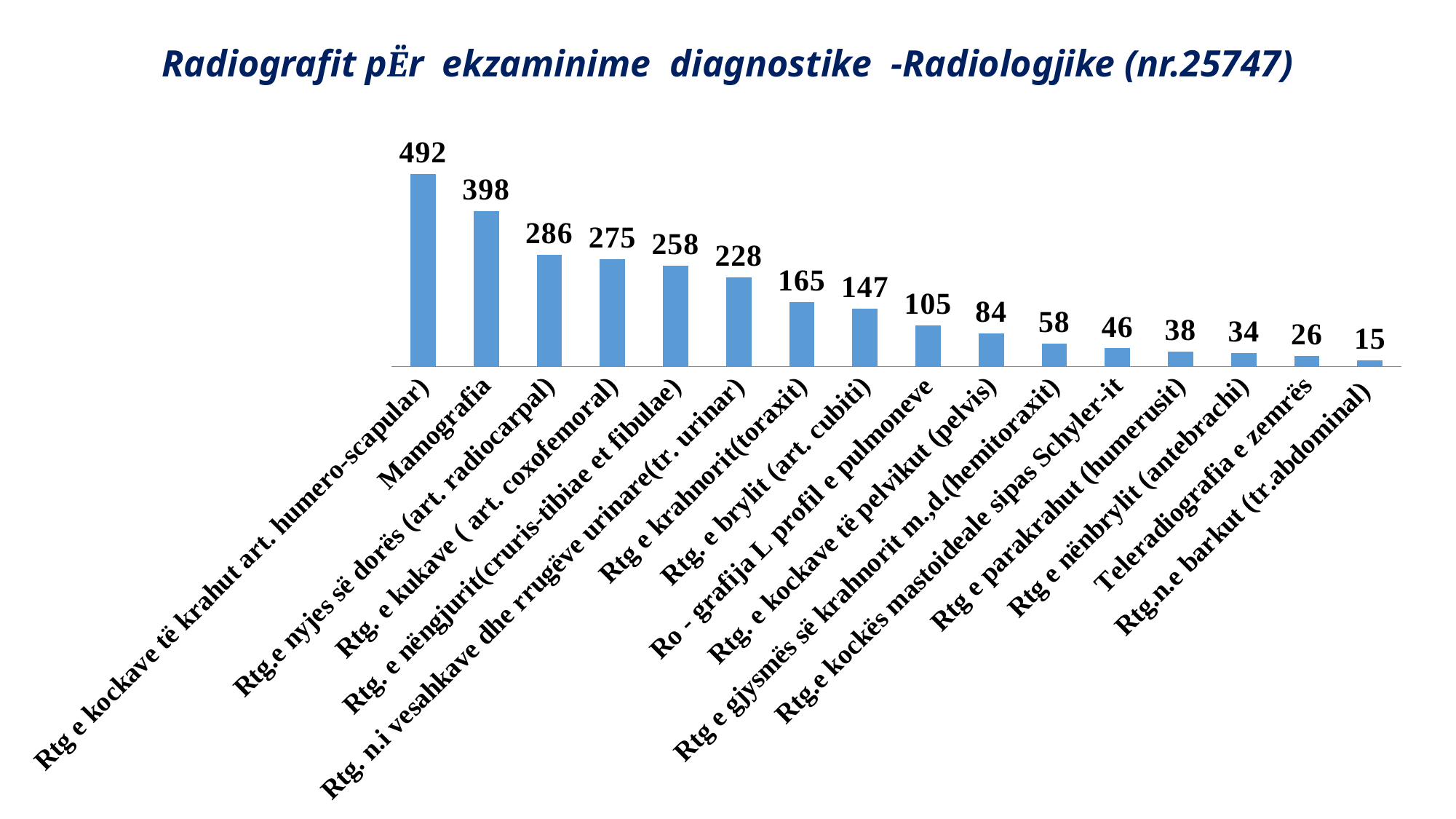
Which category has the highest value? Rtg e kockave të krahut art. humero-scapular) Which category has the lowest value? Rtg.n.e barkut (tr.abdominal) Do the values rise or fall from left to right along the x axis? Fall What is the value for Teleradiografia e zemrës? 26 What is the value for Mamografia? 398 What is the value for Rtg e krahnorit(toraxit)? 165 What is the value for Rtg. e brylit (art. cubiti)? 147 What kind of chart is shown on the slide? Bar chart What is the difference between the values for Mamografia and Rtg.e nyjes së dorës (art. radiocarpal)? 112 How many categories are shown in the chart? 16 Which is larger, the value for Ro - grafija L profil e pulmoneve or the value for Rtg. e kockave të pelvikut (pelvis)? Ro - grafija L profil e pulmoneve What is the difference between the values for Rtg. e kukave ( art. coxofemoral) and Rtg. e nëngjurit(cruris-tibiae et fibulae)? 17